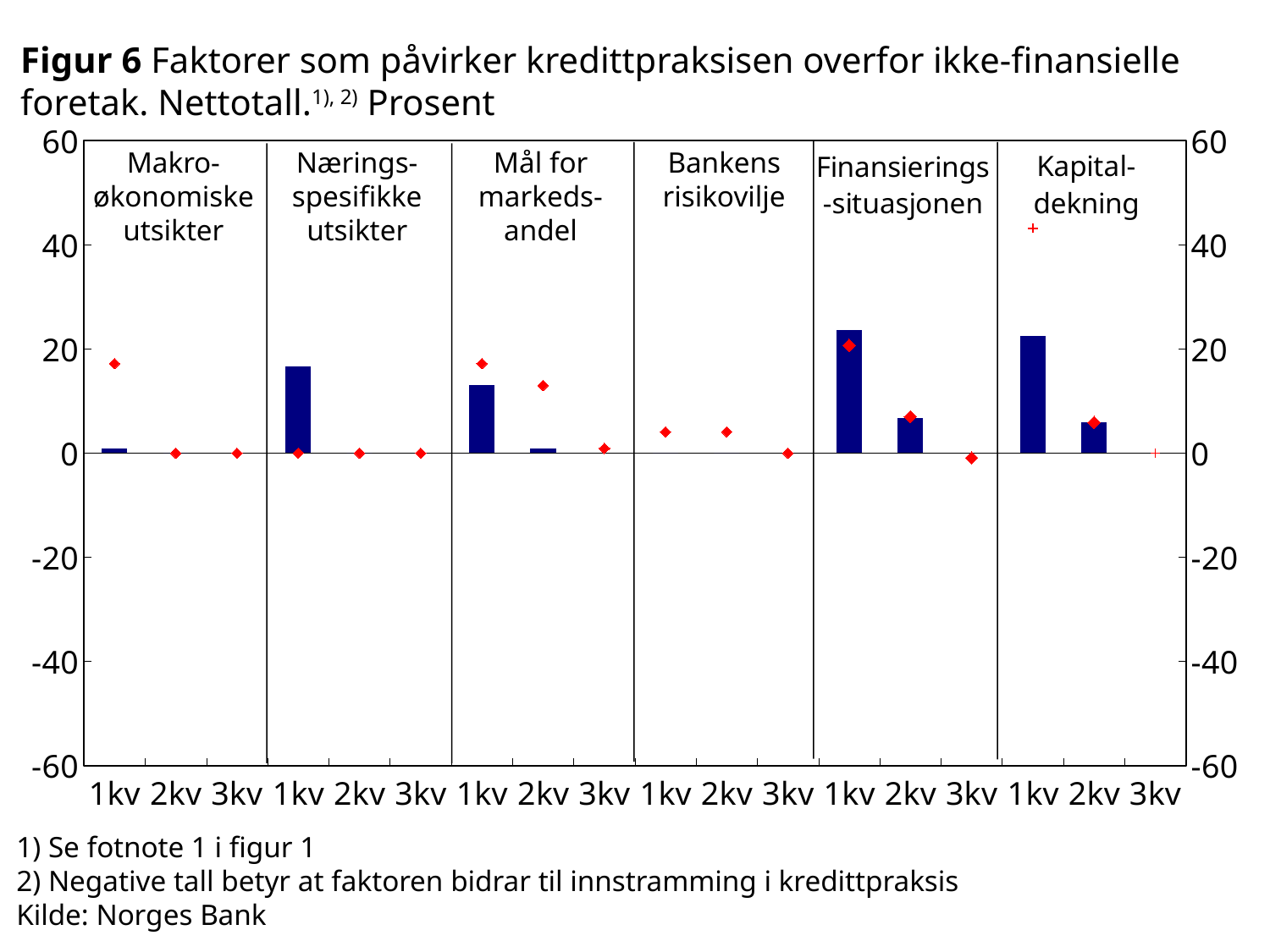
What kind of chart is shown on the slide? combination bar and line chart (bars with red diamond markers) What source is cited below the chart? Norges Bank Is the bar for 1kv under Finansieringssituasjonen greater or less than 20? greater What is the figure number given in the chart title? Figur 6 Is the red marker for 1kv under Kapitaldekning greater or less than 40? greater Which bar is taller: 1kv under Næringsspesifikke utsikter or 1kv under Mål for markedsandel? 1kv under Næringsspesifikke utsikter Is the bar for 1kv under Mål for markedsandel greater or less than 20? less Within the Finansieringssituasjonen panel, which quarter has the tallest bar? 1kv In the Kapitaldekning panel, do the bars rise or fall from 1kv to 3kv? fall How many factor panels does the chart have? 6 How many quarters (kv) are shown within each factor panel? 3